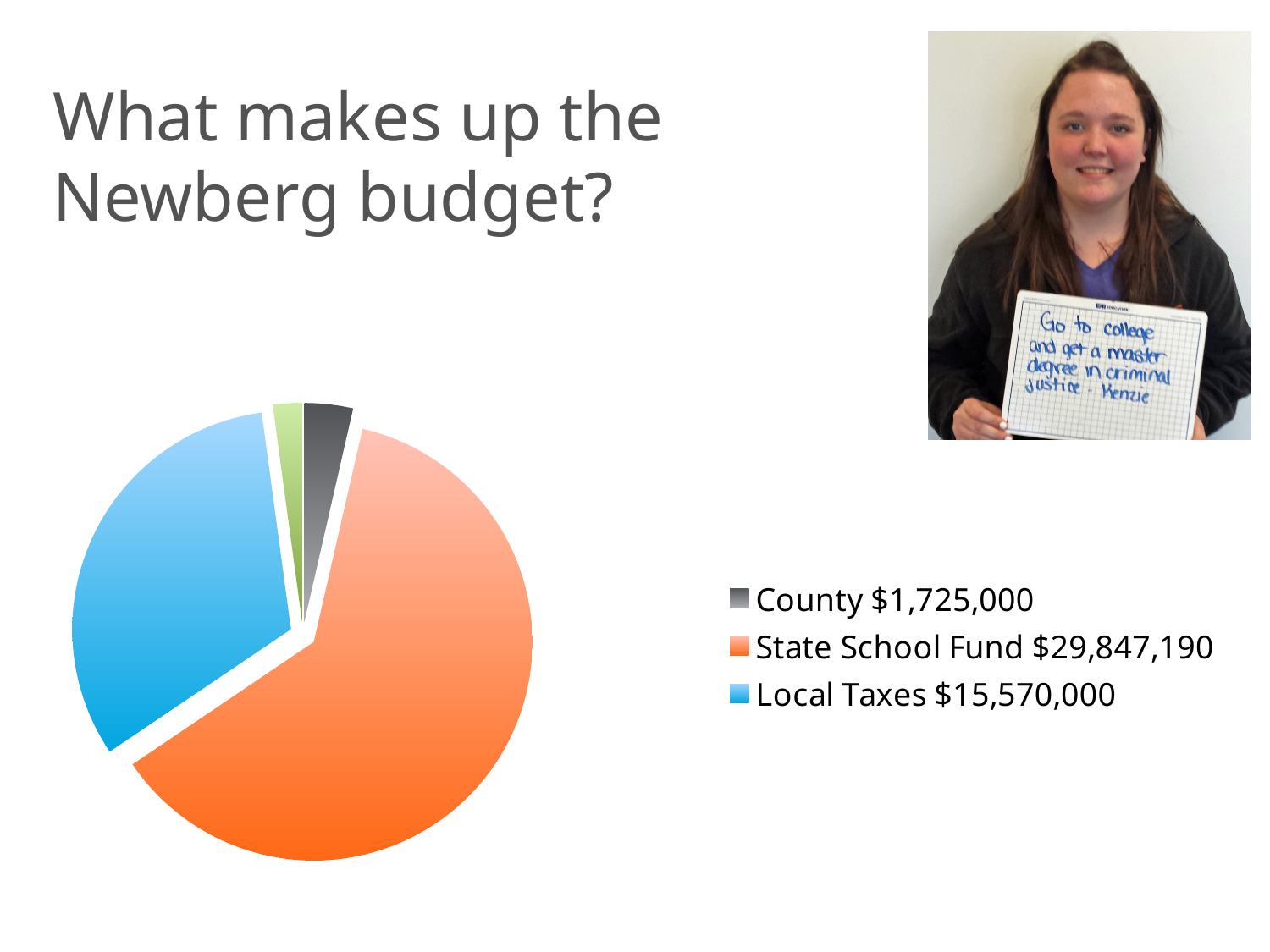
How many entries does the legend list? 3 Which legend entry has the largest value? State School Fund What is the difference between the State School Fund value and the Local Taxes value? $14,277,190 What is the value shown for County in the legend? $1,725,000 Which legend entry has the smallest value? County What colour is the State School Fund slice? orange What is the value shown for Local Taxes? $15,570,000 Which is larger, State School Fund or Local Taxes? State School Fund What kind of chart is shown on the slide? pie chart What is the value shown for State School Fund? $29,847,190 What is the difference between the Local Taxes value and the County value? $13,845,000 Which is larger, Local Taxes or County? Local Taxes